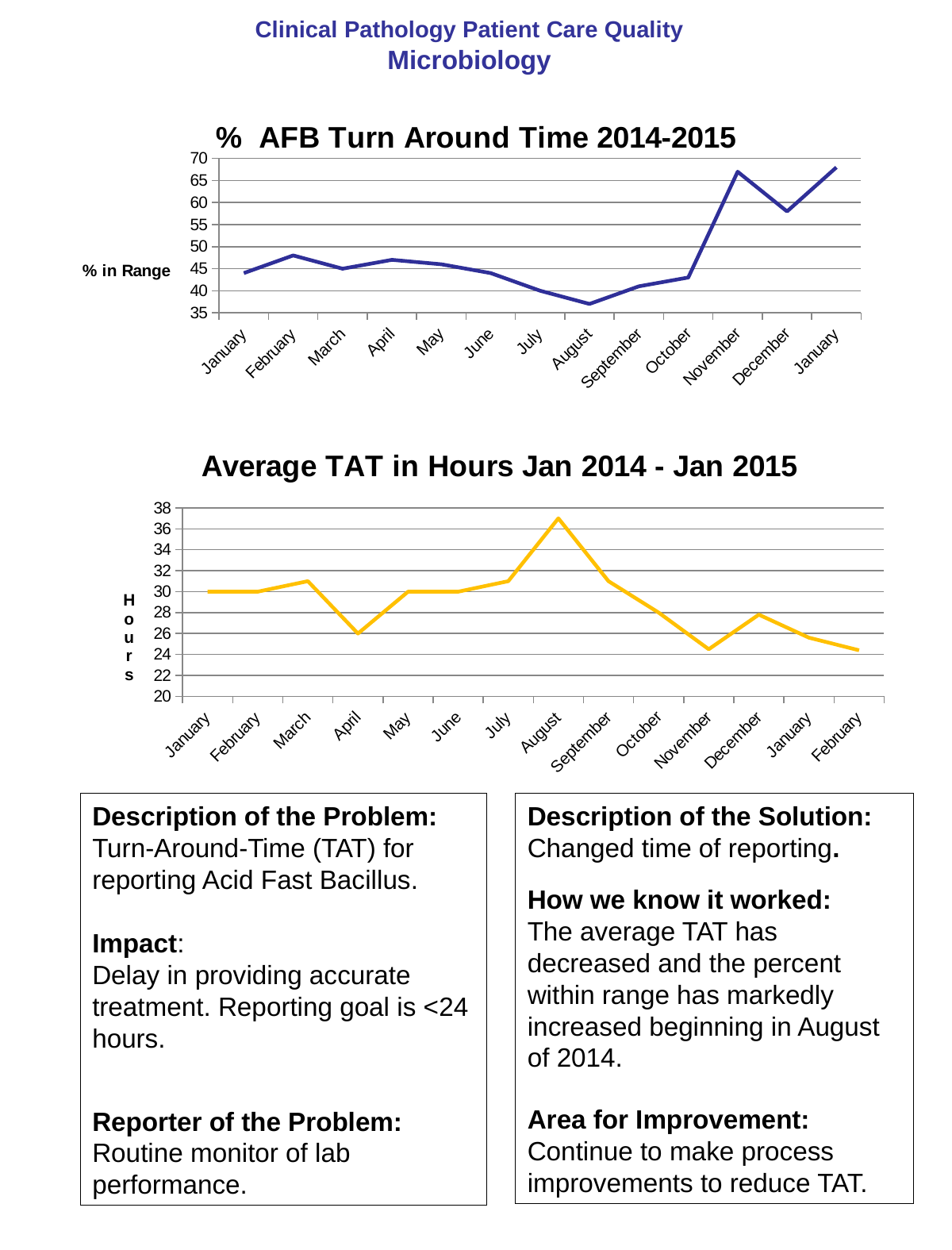
In the '% AFB Turn Around Time 2014-2015' chart, how many months are plotted along the x axis? 13 What is the y-axis label of the 'Average TAT in Hours Jan 2014 - Jan 2015' chart? Hours In the 'Average TAT in Hours Jan 2014 - Jan 2015' chart, which month has the highest value? August In the 'Average TAT in Hours Jan 2014 - Jan 2015' chart, what is the value for the first January? 30 What type of chart is the '% AFB Turn Around Time 2014-2015' chart? line chart In the '% AFB Turn Around Time 2014-2015' chart, is the value for August greater or less than 40? less In the '% AFB Turn Around Time 2014-2015' chart, is the value for November greater or less than 60? greater In the '% AFB Turn Around Time 2014-2015' chart, do the values rise or fall from February to August? fall In the 'Average TAT in Hours Jan 2014 - Jan 2015' chart, how many months are plotted along the x axis? 14 In the '% AFB Turn Around Time 2014-2015' chart, which is larger, the value for November or the value for August? November In the '% AFB Turn Around Time 2014-2015' chart, which month has the lowest value? August In the 'Average TAT in Hours Jan 2014 - Jan 2015' chart, is the value for November greater or less than 26? less